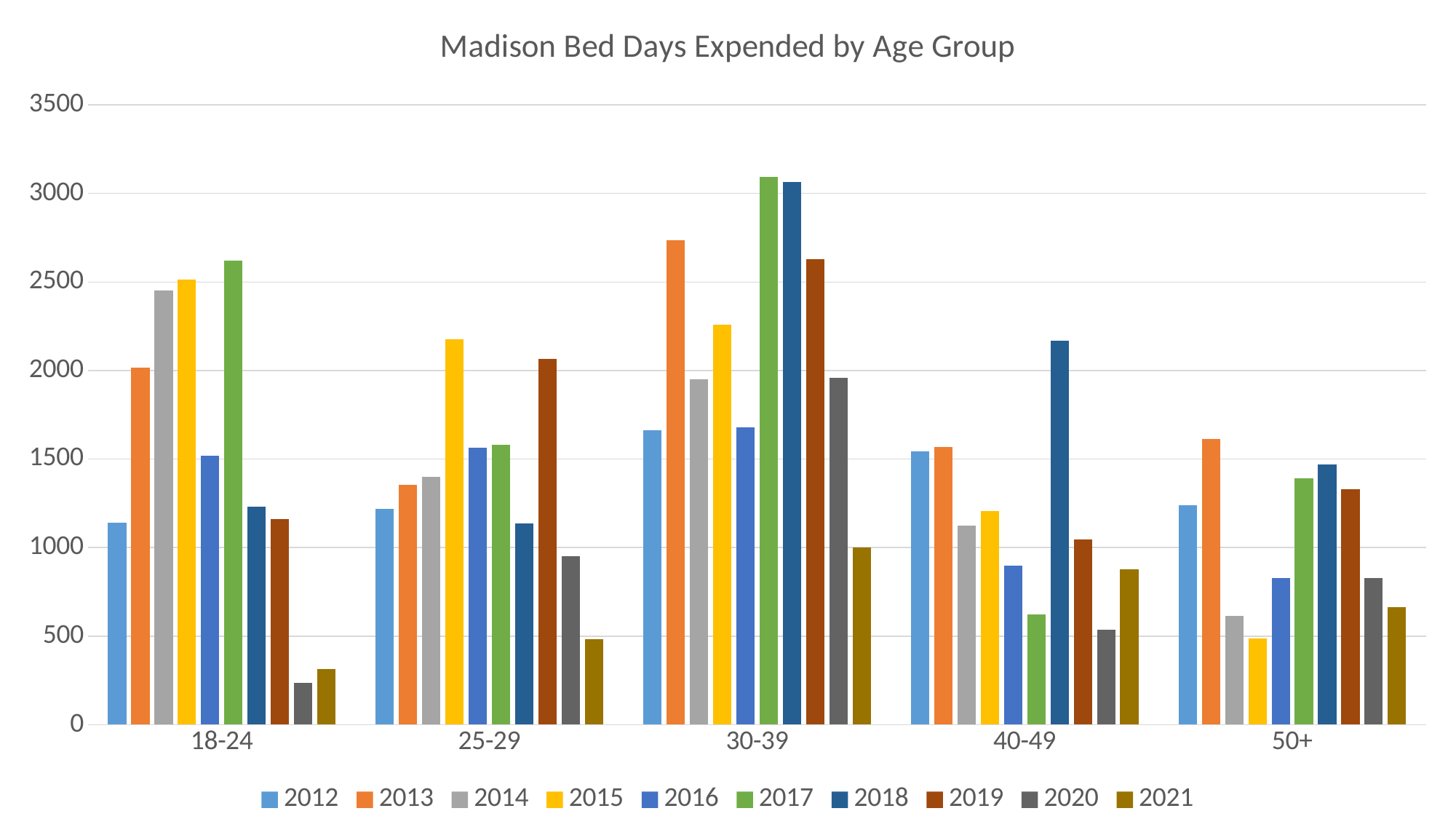
In the 50+ age group, which is larger: the value for 2012 or the value for 2013? 2013 Within the 50+ age group, which year has the lowest value? 2015 Within the 40-49 age group, which year has the highest value? 2018 How many age groups are shown on the x axis? 5 Within the 18-24 age group, which year has the highest value? 2017 Is the value for 2018 in the 40-49 age group greater or less than 2000? greater What is the title of the chart? Madison Bed Days Expended by Age Group What kind of chart is shown on the slide? bar chart Is the value for 2013 in the 30-39 age group greater or less than 2500? greater Is the value for 2021 in the 30-39 age group greater or less than 1500? less How many series does the legend list? 10